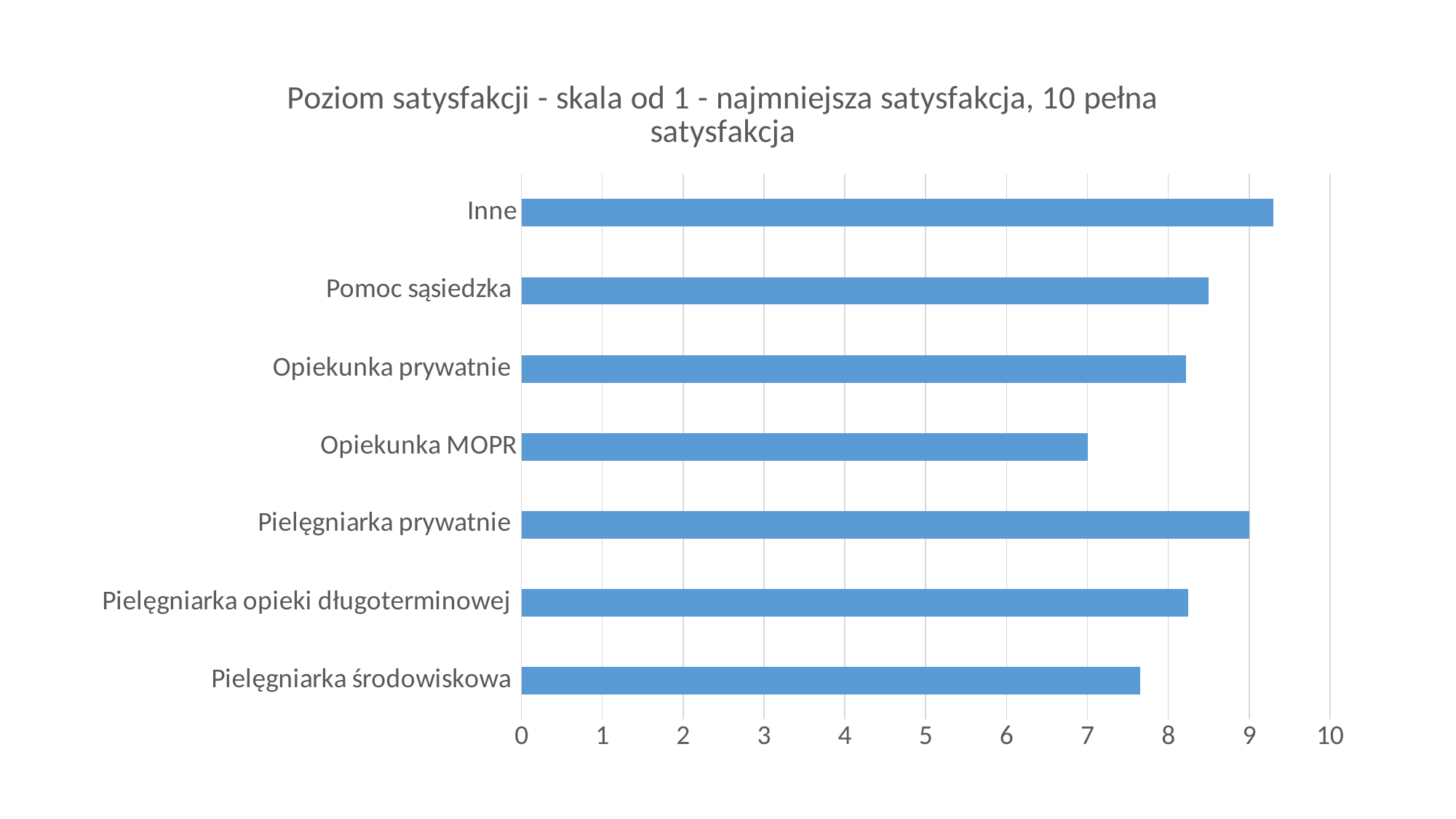
How many categories are shown in the chart? 7 What is the difference between the satisfaction levels for Pielęgniarka prywatnie and Opiekunka MOPR? 2 Which has a higher satisfaction level, Pielęgniarka środowiskowa or Opiekunka MOPR? Pielęgniarka środowiskowa What type of chart is shown on the slide? bar chart Is the value for Pomoc sąsiedzka greater or less than 8? greater Is the value for Pielęgniarka środowiskowa greater or less than 8? less What is the satisfaction level for Opiekunka MOPR? 7 Which category has the lowest satisfaction level? Opiekunka MOPR Which category has the highest satisfaction level? Inne Which has a higher satisfaction level, Inne or Pielęgniarka prywatnie? Inne What is the satisfaction level for Pielęgniarka prywatnie? 9 What is the title of the chart? Poziom satysfakcji - skala od 1 - najmniejsza satysfakcja, 10 pełna satysfakcja